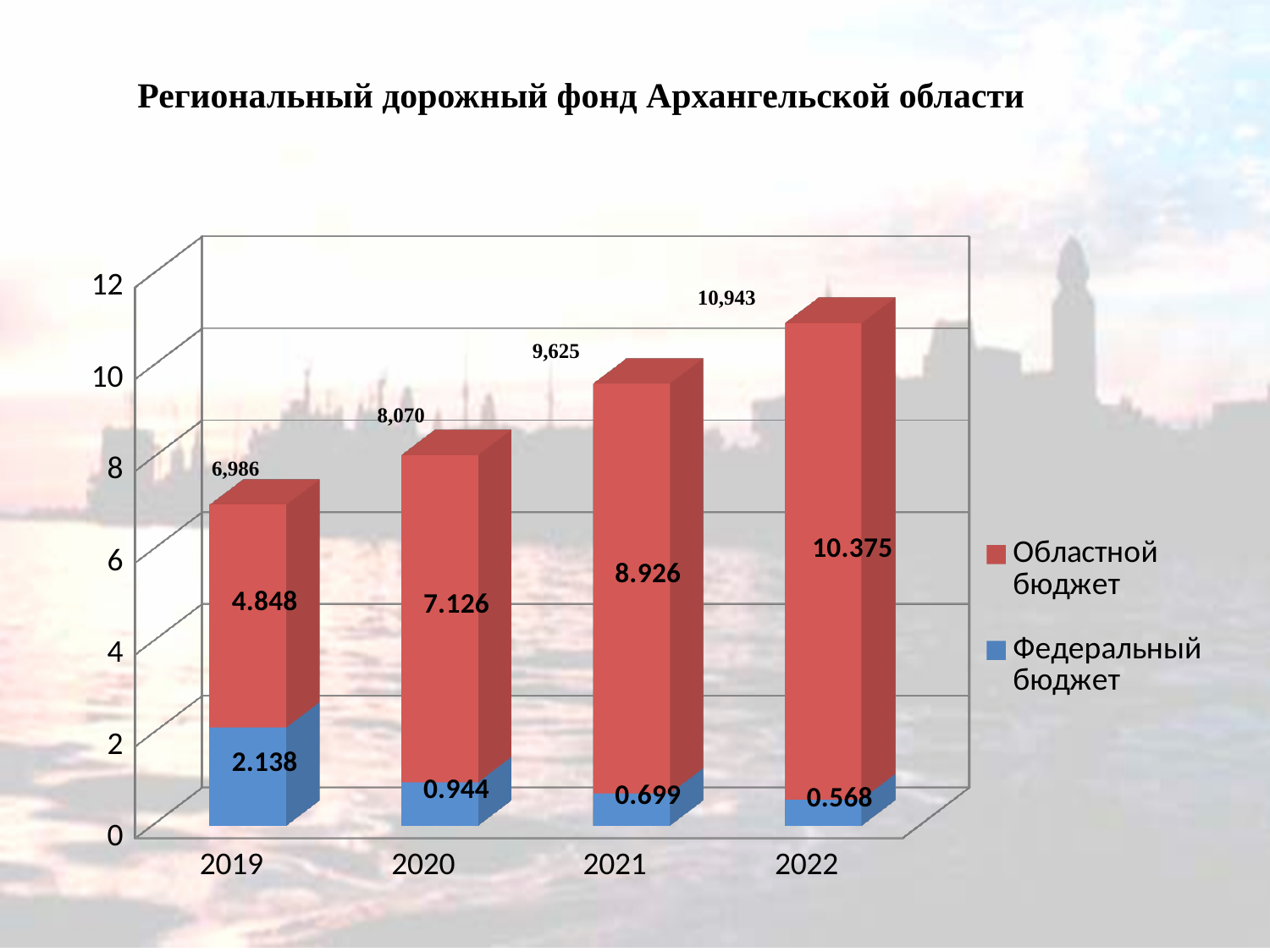
What total is labelled above the 2020 bar? 8,070 How many series does the legend list? 2 What is the difference between the Областной бюджет values for 2022 and 2021? 1.449 What kind of chart is shown on the slide? Stacked bar chart What is the value of Федеральный бюджет for 2019? 2.138 Which is larger: Федеральный бюджет in 2020 or in 2021? 2020 What is the value of Областной бюджет for 2020? 7.126 How many years are shown on the x axis? 4 What is the value of Областной бюджет for 2021? 8.926 What is the value of Федеральный бюджет for 2022? 0.568 Which year has the highest value for Областной бюджет? 2022 Which year has the lowest value for Федеральный бюджет? 2022